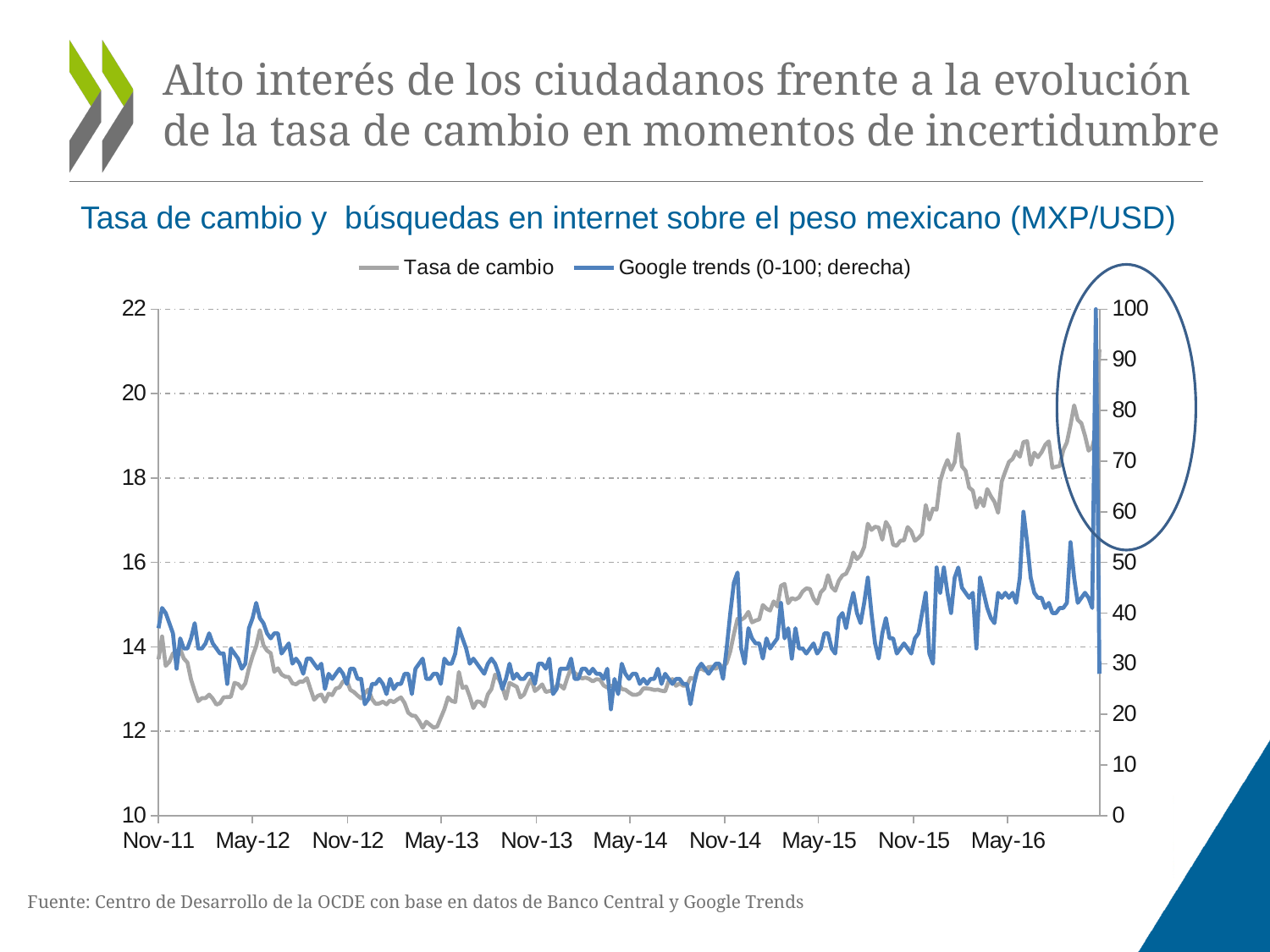
Is the highest 'Google trends' value on the chart greater or less than 90? greater Does the 'Tasa de cambio' series rise or fall overall from Nov-11 to 2016? rise Is the 'Tasa de cambio' value at Nov-15 greater or less than 16? greater What kind of chart is shown on the slide? line chart What is the maximum value shown on the left-hand axis? 22 How many date labels are shown on the x axis? 10 Which is larger for 'Tasa de cambio': the value at Nov-11 or the value at Nov-15? Nov-15 Is the 'Tasa de cambio' value at May-13 greater or less than 14? less How many series does the legend list? 2 What colour is the 'Tasa de cambio' line? grey Which series is plotted on the right-hand axis? Google trends (0-100; derecha)